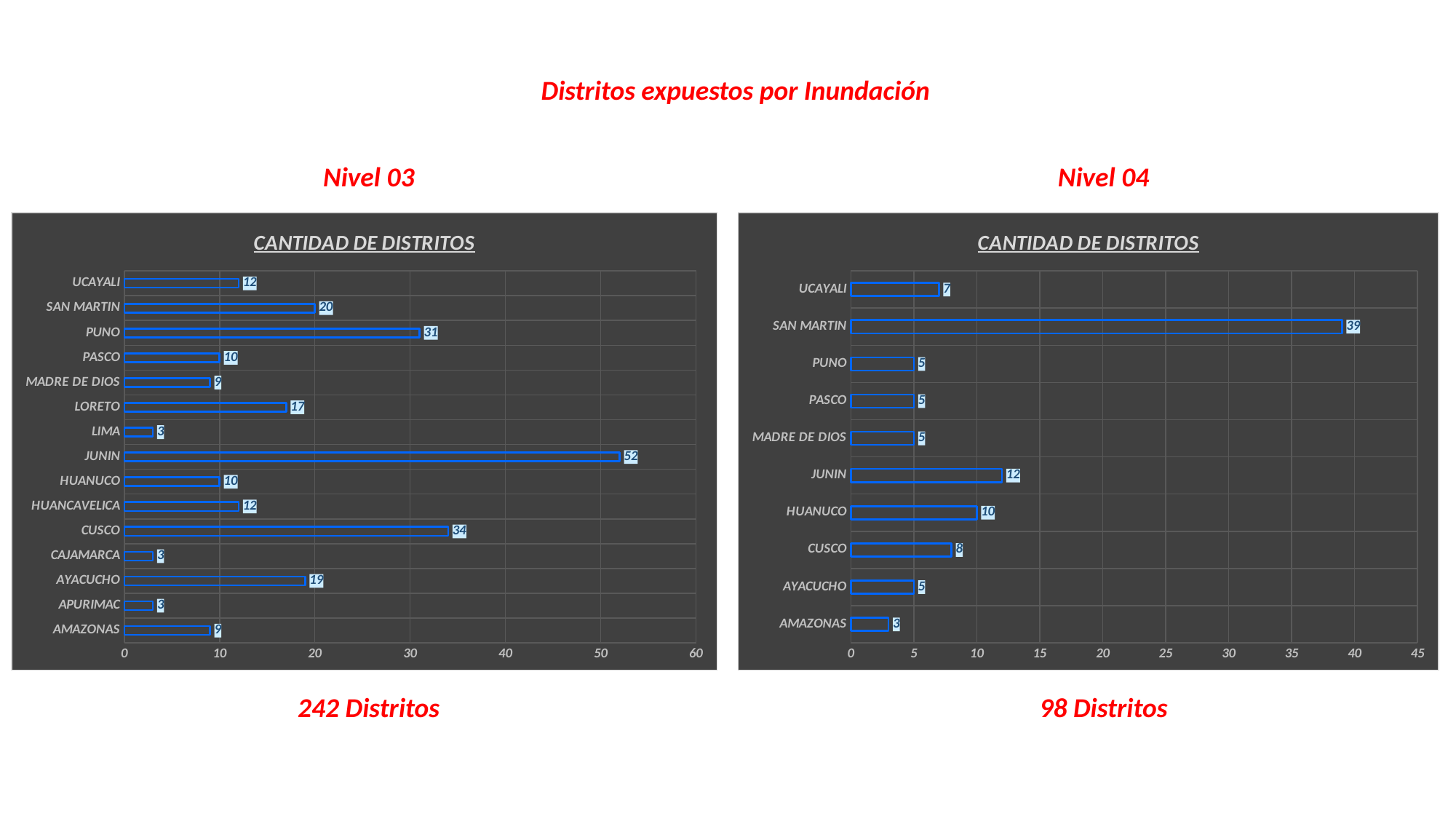
In the Nivel 04 chart on the right, what is the value for SAN MARTIN? 39 In the Nivel 03 chart on the left, what is the value for LORETO? 17 In the Nivel 03 chart on the left, is the value for AYACUCHO greater or less than 20? less In the Nivel 04 chart on the right, which category has the lowest value? AMAZONAS How many categories are shown in the Nivel 04 chart on the right? 10 In the Nivel 03 chart on the left, which category has the highest value? JUNIN How many categories are shown in the Nivel 03 chart on the left? 15 In the Nivel 03 chart on the left, what is the value for JUNIN? 52 What is the title shown inside the Nivel 03 chart on the left? CANTIDAD DE DISTRITOS In the Nivel 04 chart on the right, which is larger, the value for JUNIN or the value for HUANUCO? JUNIN What kind of chart is the Nivel 04 chart on the right? bar chart In the Nivel 03 chart on the left, what is the difference between the values for CUSCO and PUNO? 3